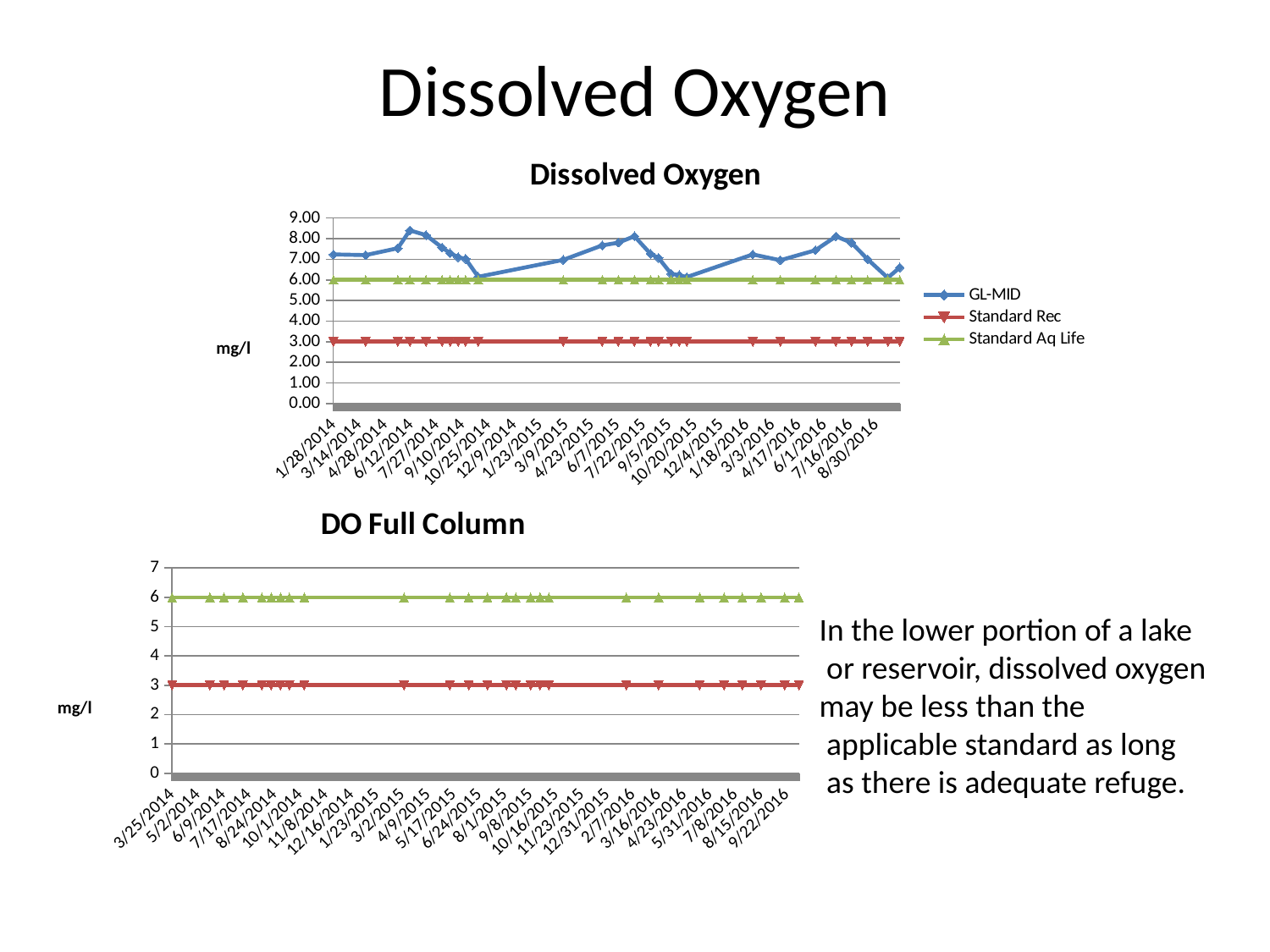
In the "Dissolved Oxygen" chart, is the GL-MID value on 1/28/2014 greater or less than 6.00? greater In the "DO Full Column" chart, what value does the lower (red) line sit at? 3 In the "Dissolved Oxygen" chart, which is higher, the Standard Aq Life line or the Standard Rec line? Standard Aq Life In the "Dissolved Oxygen" chart, is the GL-MID value on 1/28/2014 greater or less than 8.00? less In the "Dissolved Oxygen" chart, what is the difference between the Standard Aq Life line and the Standard Rec line? 3.00 What are the three series named in the legend of the "Dissolved Oxygen" chart? GL-MID, Standard Rec, Standard Aq Life How many series does the legend of the "Dissolved Oxygen" chart list? 3 In the "DO Full Column" chart, what value does the upper (green) line sit at? 6 What is the unit shown on the y-axis of the "DO Full Column" chart? mg/l In the "Dissolved Oxygen" chart, what value does the Standard Rec line sit at? 3.00 What kind of chart is the top chart titled "Dissolved Oxygen"? Line chart In the "Dissolved Oxygen" chart, what value does the Standard Aq Life line sit at? 6.00